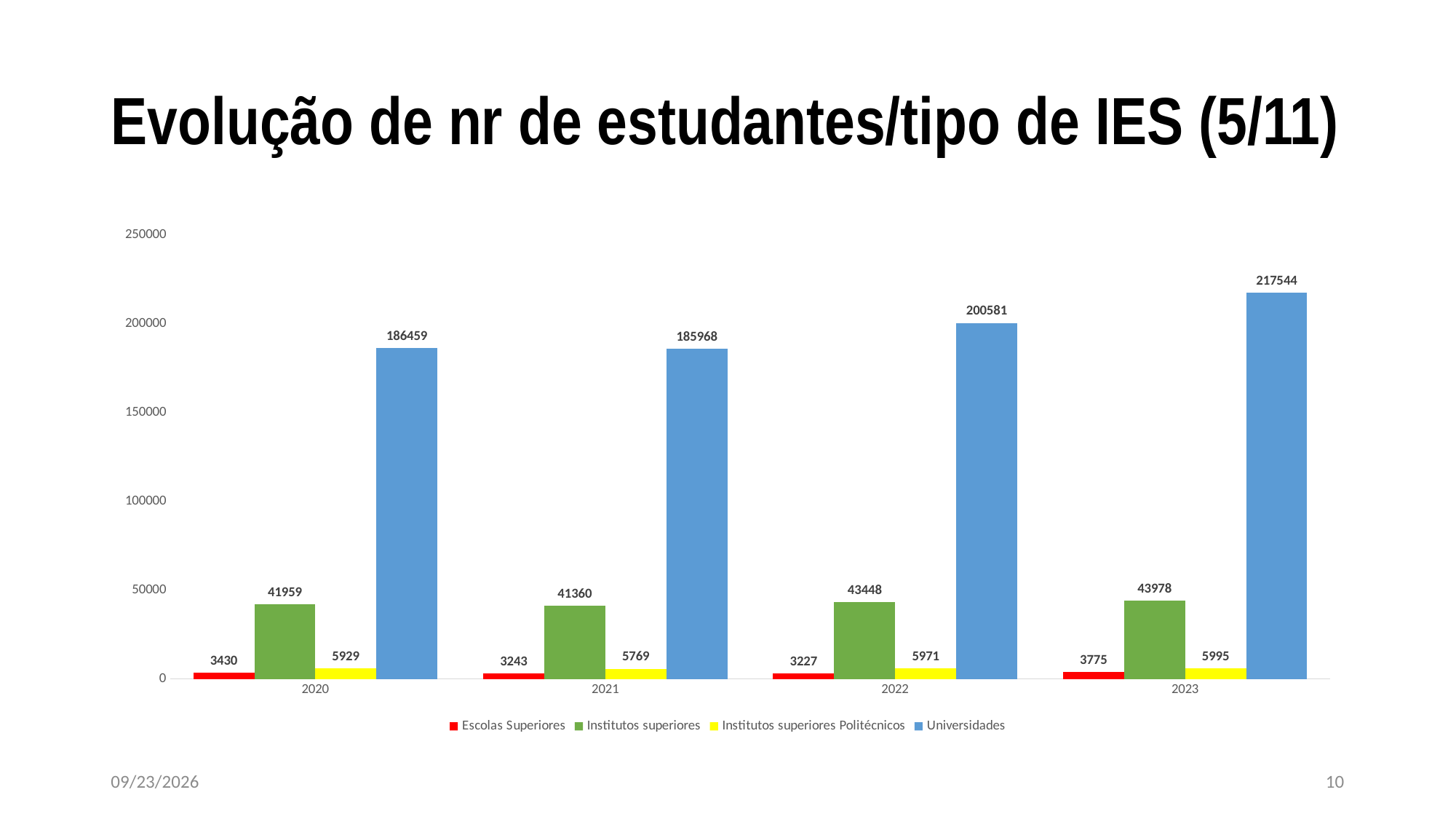
What kind of chart is shown on the slide? bar chart In which year is the value for Universidades highest? 2023 How many years are shown on the x axis? 4 In which year is the value for Escolas Superiores lowest? 2022 What is the value for Universidades in 2022? 200581 How many series does the legend list? 4 Which is larger, the Institutos superiores value in 2020 or in 2021? 2020 What is the difference between the Universidades values for 2023 and 2022? 16963 What is the value for Institutos superiores in 2021? 41360 What is the value for Institutos superiores Politécnicos in 2020? 5929 Is the value for Universidades in 2021 greater or less than 200000? less What is the value for Escolas Superiores in 2023? 3775